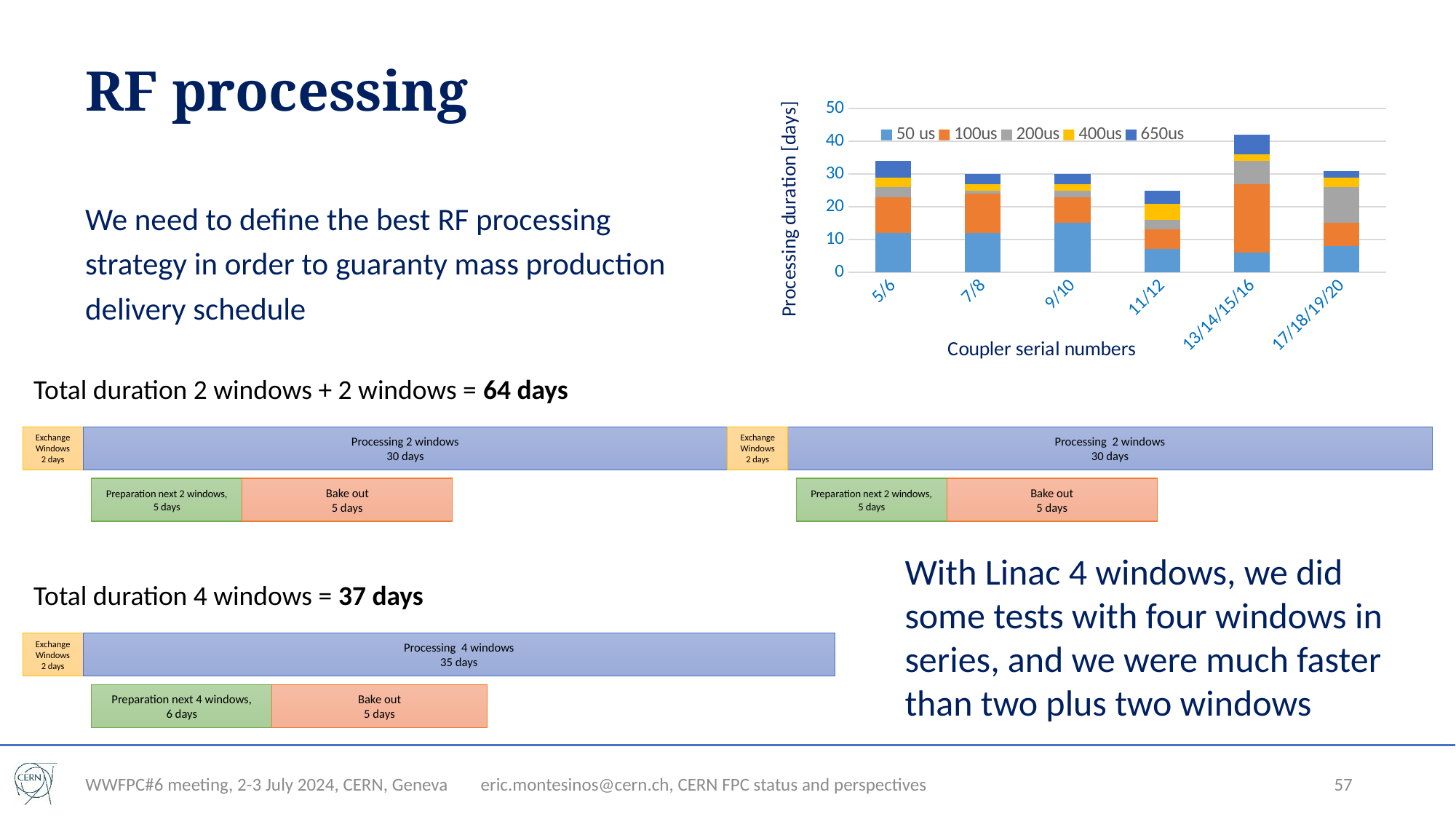
How many series does the chart's legend list? 5 Which coupler serial number has the highest total processing duration? 13/14/15/16 How many coupler serial number categories are shown on the x axis of the chart? 6 What is the label of the chart's horizontal axis? Coupler serial numbers Is the 50 us segment for coupler 9/10 greater or less than 10 days? greater What is the label of the chart's vertical axis? Processing duration [days] Is the total processing duration for 11/12 greater or less than 30 days? less Which has a larger total processing duration, coupler 13/14/15/16 or coupler 11/12? 13/14/15/16 What kind of chart is shown on the slide? stacked bar chart Which coupler serial number has the lowest total processing duration? 11/12 Is the total processing duration for 13/14/15/16 greater or less than 40 days? greater